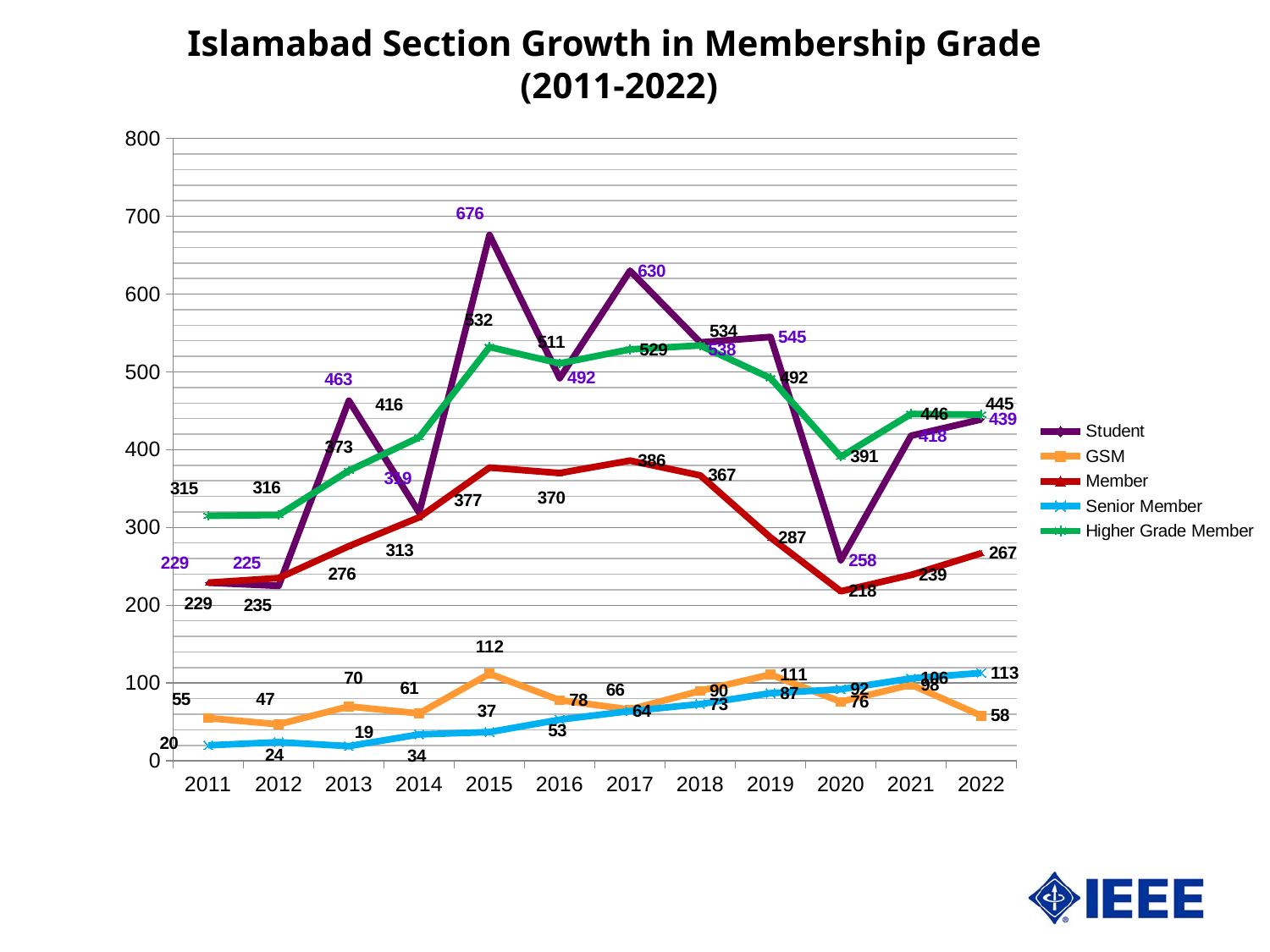
In which year is the Senior Member value lowest? 2013 What is the Student value in 2015? 676 What is the Senior Member value in 2022? 113 What is the difference between the Student values in 2015 and 2017? 46 What is the Member value in 2020? 218 How many years are plotted along the x axis? 12 Does the Senior Member series generally rise or fall from 2011 to 2022? rise In 2017, which is larger: the Member value or the Higher Grade Member value? Higher Grade Member What is the GSM value in 2015? 112 In which year does the Student series reach its highest value? 2015 How many series does the legend list? 5 What type of chart is shown on the slide? line chart